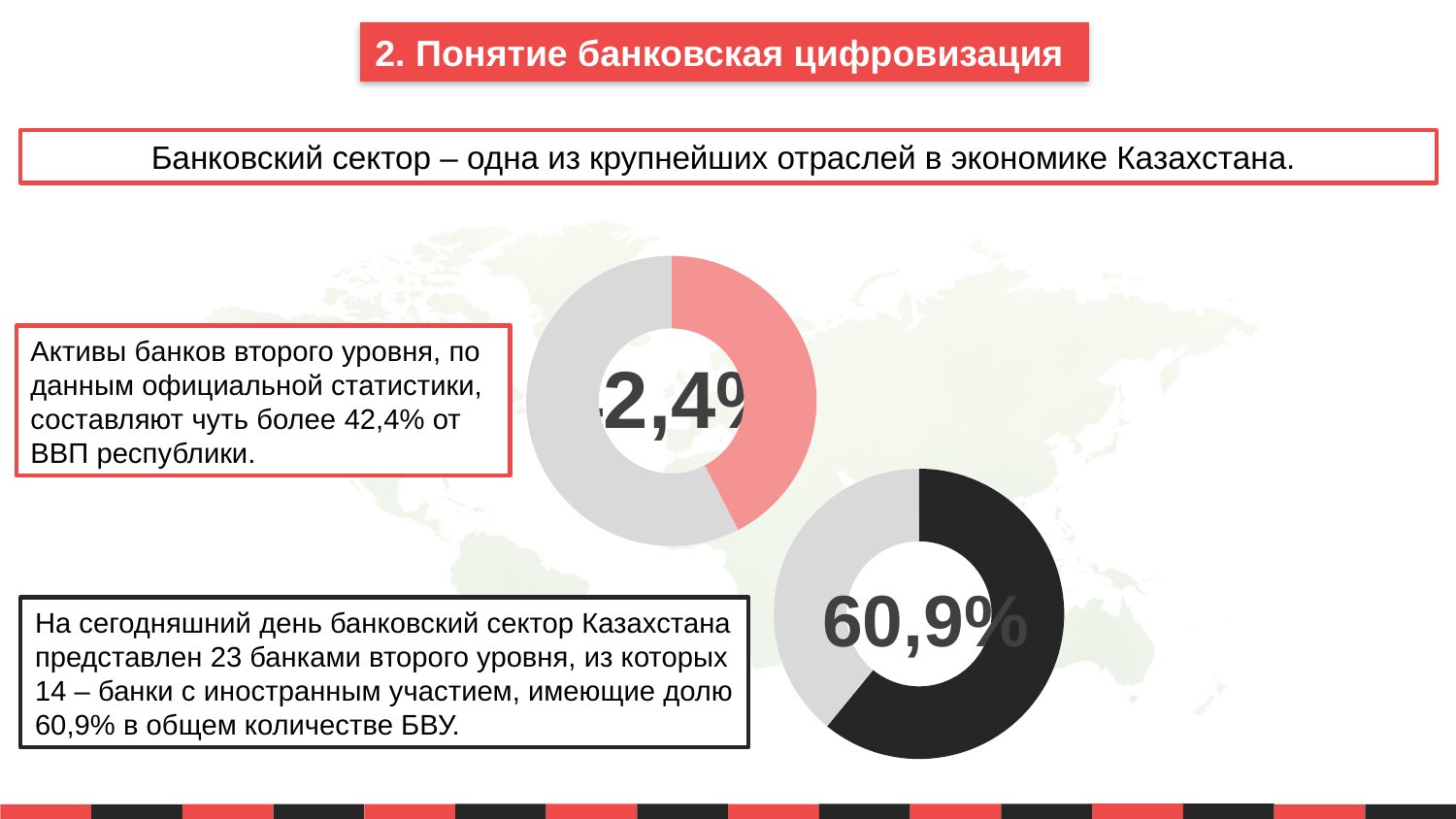
In the lower chart, is the black segment greater or less than 50% of the donut? greater What is the difference between the percentage in the lower chart and the percentage in the upper chart? 18,5 percentage points What colour is the highlighted segment in the lower chart? Black What colour is the highlighted segment in the upper chart? Pink (red) In the lower chart, what share of the donut is the grey segment? 39,1% How many charts are shown on the slide? 2 In the upper chart, what share of GDP do the assets of second-tier banks represent, according to the slide? 42,4% What kind of chart is the lower chart with the black segment? Donut (pie) chart In the lower chart, what percentage is shown in the centre? 60,9% Which chart shows the larger highlighted share: the upper chart (pink) or the lower chart (black)? The lower chart (black), 60,9% In the upper chart, is the pink segment greater or less than 50% of the donut? less What kind of chart is the upper chart with the pink segment? Donut (pie) chart